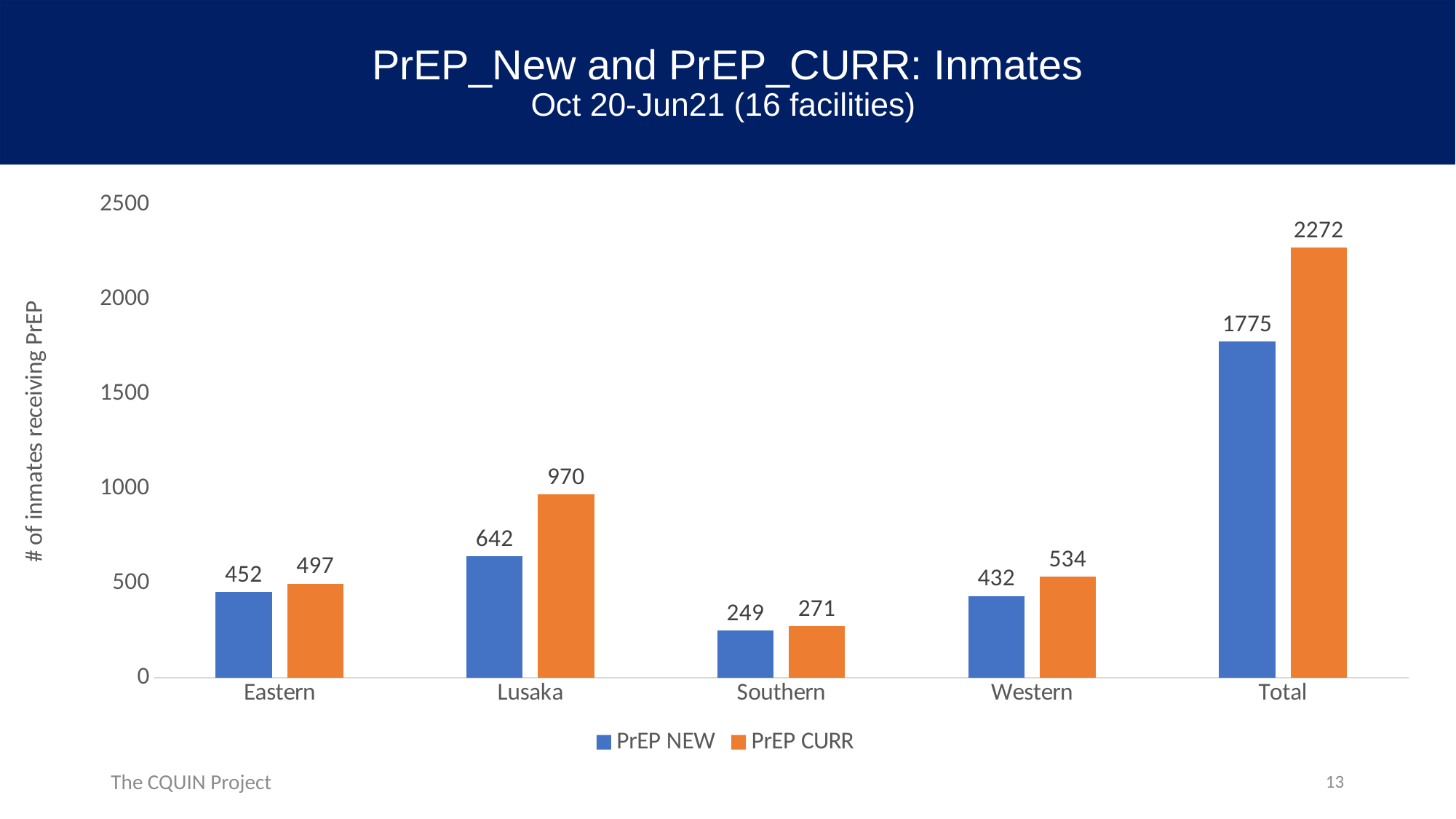
Which province has the lowest PrEP NEW value? Southern Is the PrEP CURR value for Lusaka greater or less than 1000? less What is the PrEP CURR value for Western? 534 How many series does the legend list? 2 What is the difference between the Total PrEP CURR and Total PrEP NEW values? 497 What is the PrEP NEW value for Lusaka? 642 What kind of chart is shown on the slide? bar chart What is the PrEP CURR value for Total? 2272 What is the difference between PrEP CURR and PrEP NEW for Lusaka? 328 Excluding the Total category, which province has the highest PrEP CURR value? Lusaka How many categories are shown on the x axis? 5 Which is larger, the PrEP NEW value for Eastern or the PrEP NEW value for Western? Eastern